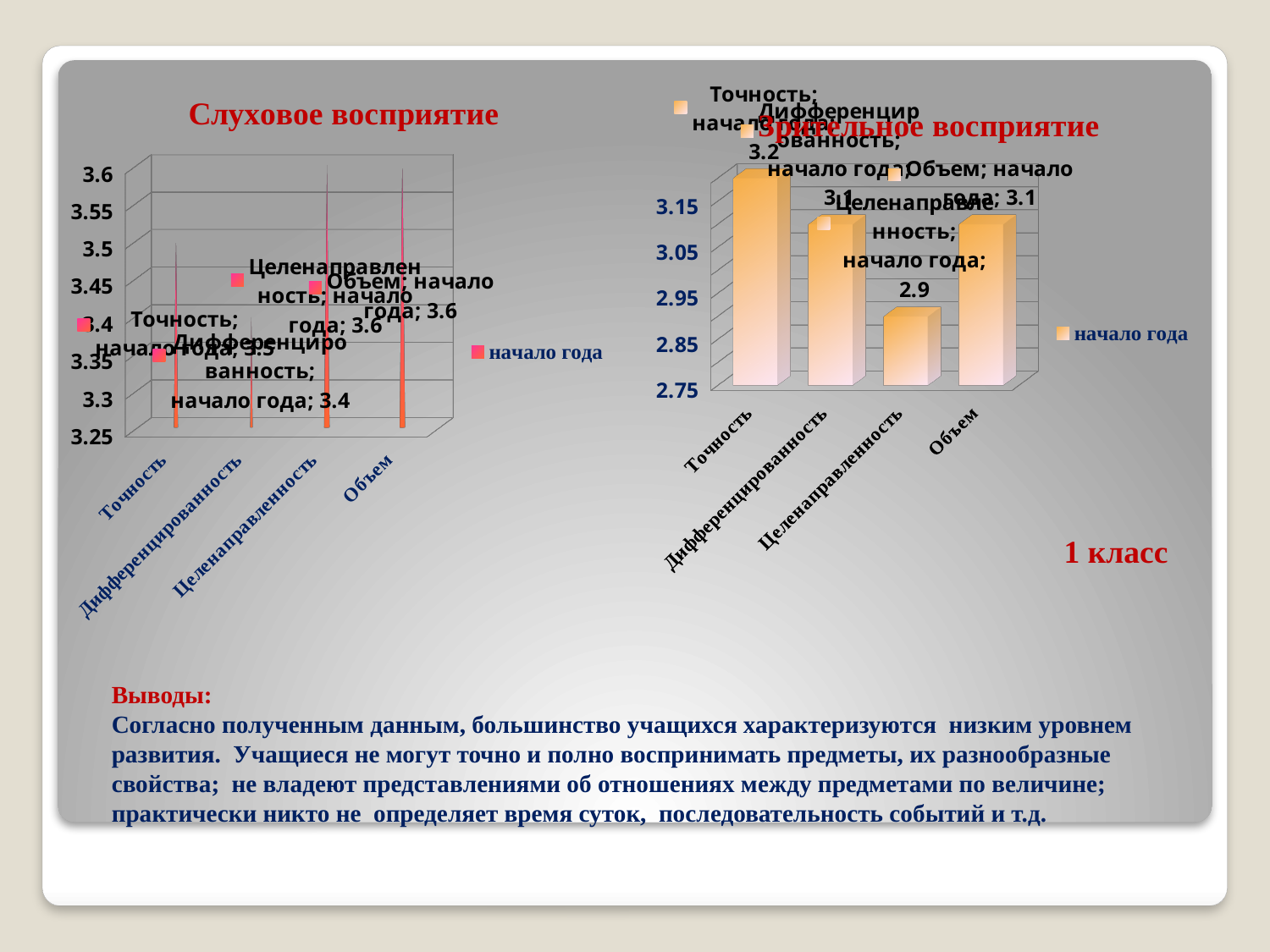
On the 'Слуховое восприятие' chart, which category has the lowest value? Дифференцированность On the 'Зрительное восприятие' chart, what is the value for Точность? 3.2 On the 'Зрительное восприятие' chart, which category has the lowest value? Целенаправленность How many categories are shown on the 'Зрительное восприятие' chart? 4 On the 'Зрительное восприятие' chart, is the value for Целенаправленность greater or less than 2.95? less On the 'Слуховое восприятие' chart, which is larger, the value for Целенаправленность or the value for Дифференцированность? Целенаправленность On the 'Слуховое восприятие' chart, what is the value for Объем? 3.6 How many series does the legend of the 'Слуховое восприятие' chart list? 1 On the 'Зрительное восприятие' chart, which category has the highest value? Точность On the 'Зрительное восприятие' chart, what is the difference between the values for Точность and Целенаправленность? 0.3 On the 'Зрительное восприятие' chart, what is the value for Целенаправленность? 2.9 On the 'Слуховое восприятие' chart, what is the value for Дифференцированность? 3.4